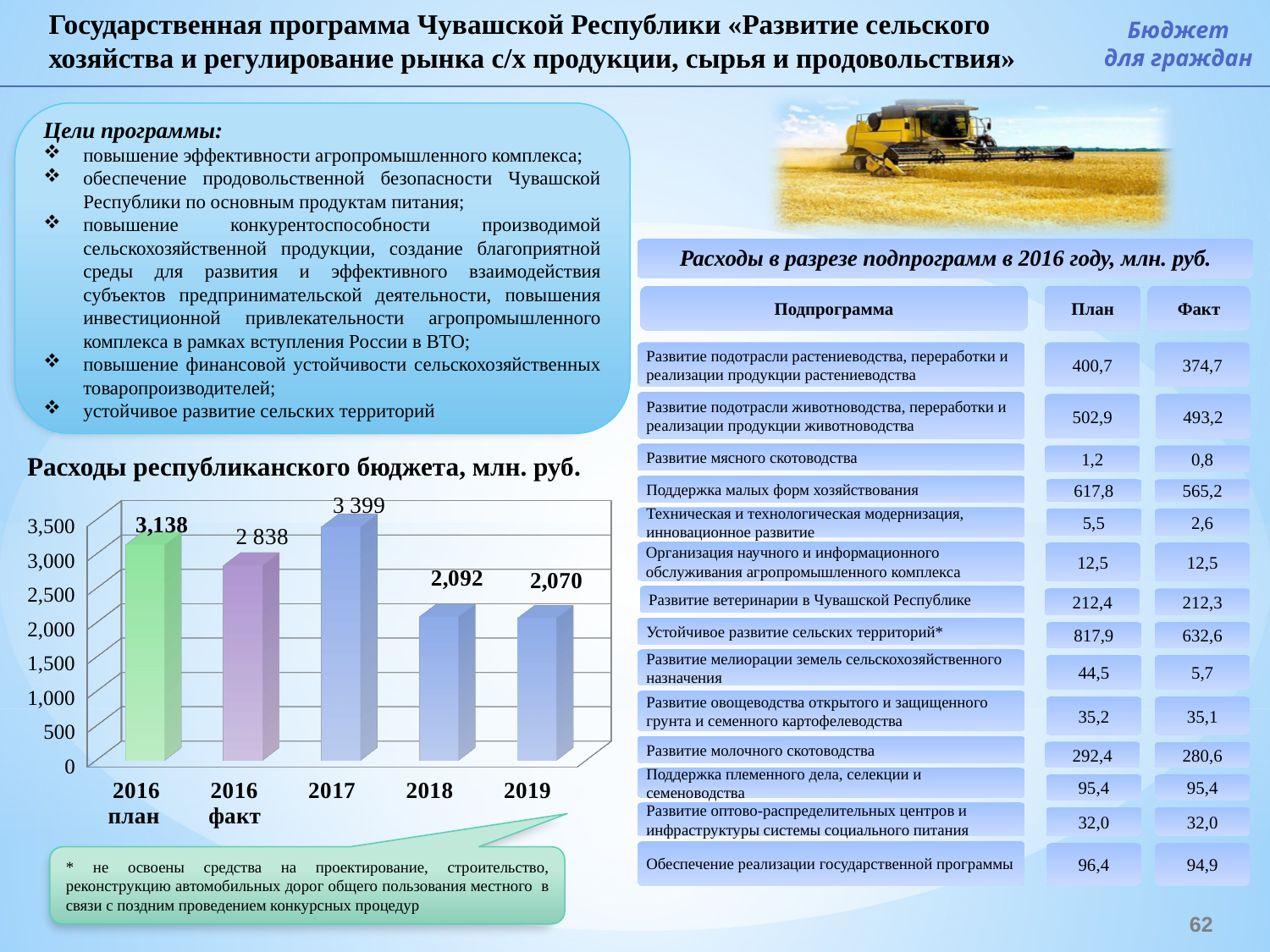
In the chart «Расходы республиканского бюджета, млн. руб.», what is the value for 2017? 3 399 In the chart «Расходы республиканского бюджета, млн. руб.», what is the difference between the 2018 and 2019 values? 22 In the chart «Расходы республиканского бюджета, млн. руб.», which category has the highest value? 2017 In the chart «Расходы республиканского бюджета, млн. руб.», which is larger: the value for 2017 or the value for «2016 план»? 2017 What type of chart is shown under the title «Расходы республиканского бюджета, млн. руб.»? bar chart In the chart «Расходы республиканского бюджета, млн. руб.», what is the value for 2019? 2,070 In the chart «Расходы республиканского бюджета, млн. руб.», is the value for 2018 greater or less than 2,500? less In the chart «Расходы республиканского бюджета, млн. руб.», what is the value for «2016 факт»? 2 838 In the chart «Расходы республиканского бюджета, млн. руб.», what is the value for «2016 план»? 3,138 In the chart «Расходы республиканского бюджета, млн. руб.», which category has the lowest value? 2019 How many bars are plotted in the chart «Расходы республиканского бюджета, млн. руб.»? 5 In the chart «Расходы республиканского бюджета, млн. руб.», what is the difference between «2016 план» and «2016 факт»? 300